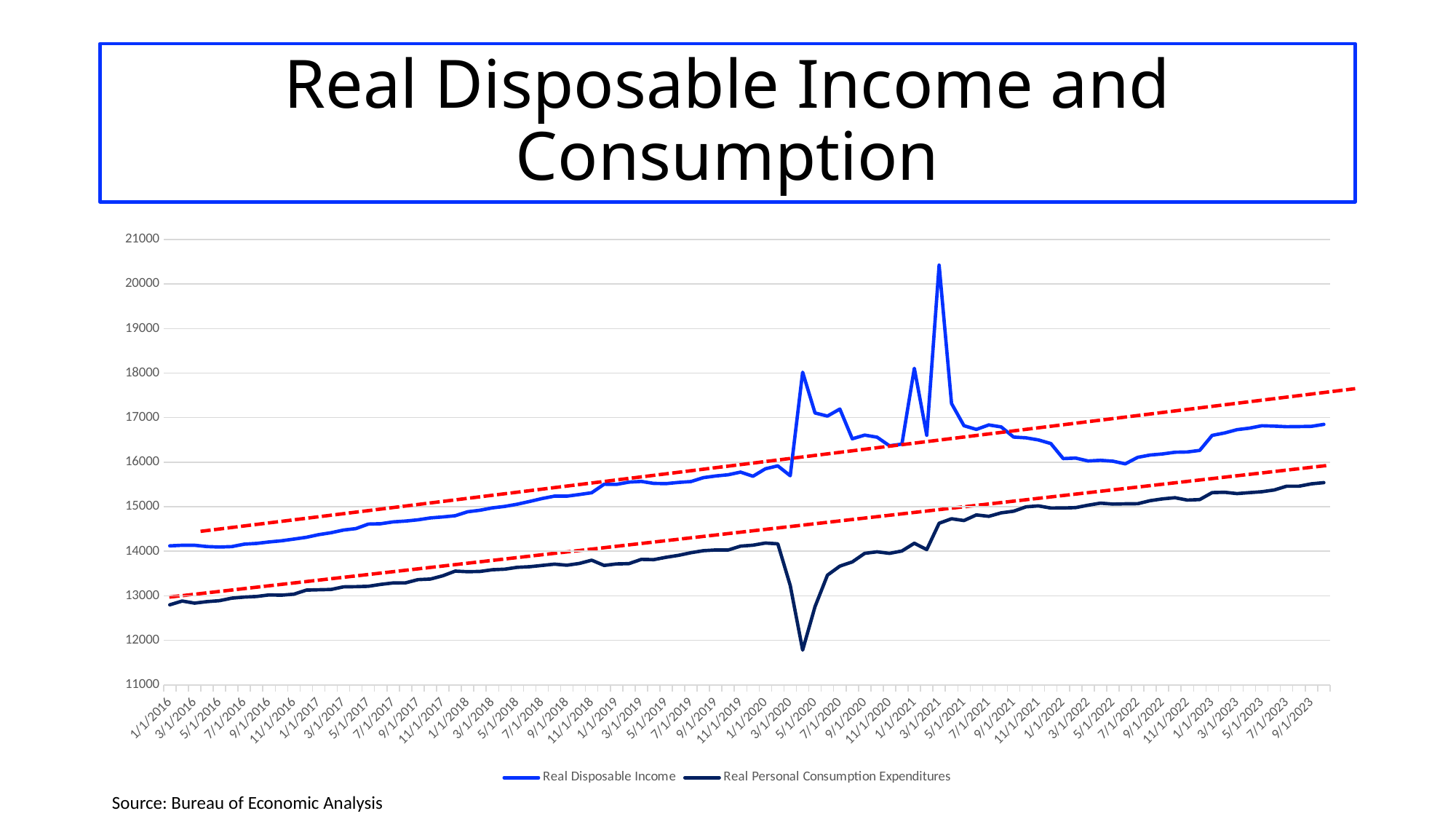
In which year does Real Disposable Income reach its highest point? 2021 What are the two series named in the legend? Real Disposable Income and Real Personal Consumption Expenditures Is the value for Real Disposable Income at 9/1/2023 greater or less than 16000? greater Is the value for Real Personal Consumption Expenditures at 9/1/2023 greater or less than 15000? greater What kind of chart is shown on the slide? line chart How many series does the legend list? 2 Is the value for Real Personal Consumption Expenditures at 1/1/2016 greater or less than 13000? less What is the title of the chart? Real Disposable Income and Consumption Overall, do the values for Real Personal Consumption Expenditures rise or fall from 1/1/2016 to 9/1/2023? rise Which series is higher across the whole period, Real Disposable Income or Real Personal Consumption Expenditures? Real Disposable Income